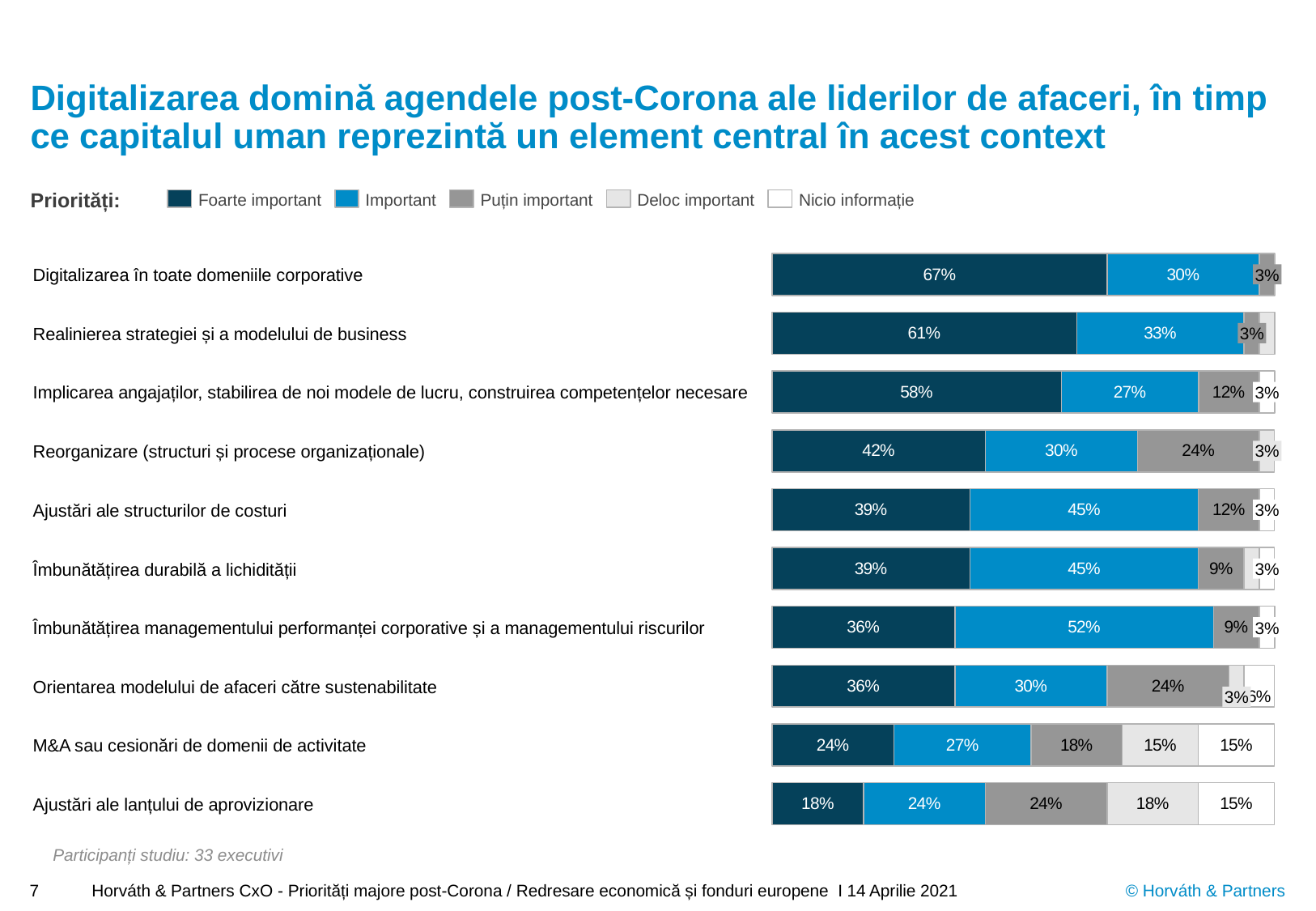
What is the Puțin important share for "Reorganizare (structuri și procese organizaționale)"? 24% Which has a larger Important share: "Ajustări ale structurilor de costuri" or "Reorganizare (structuri și procese organizaționale)"? Ajustări ale structurilor de costuri Which priority has the lowest Foarte important share? Ajustări ale lanțului de aprovizionare What percentage of respondents rated "Digitalizarea în toate domeniile corporative" as Foarte important? 67% Which legend entry is shown in the darkest blue colour? Foarte important By how many percentage points does the Foarte important share for "Digitalizarea în toate domeniile corporative" exceed that for "Realinierea strategiei și a modelului de business"? 6 percentage points What is the Deloc important share for "M&A sau cesionări de domenii de activitate"? 15% What type of chart is shown on the slide? Stacked horizontal bar chart How many rating categories does the legend list? 5 How many priorities are listed in the chart? 10 What is the Important share for "Îmbunătățirea managementului performanței corporative și a managementului riscurilor"? 52% Which priority has the highest Foarte important share? Digitalizarea în toate domeniile corporative